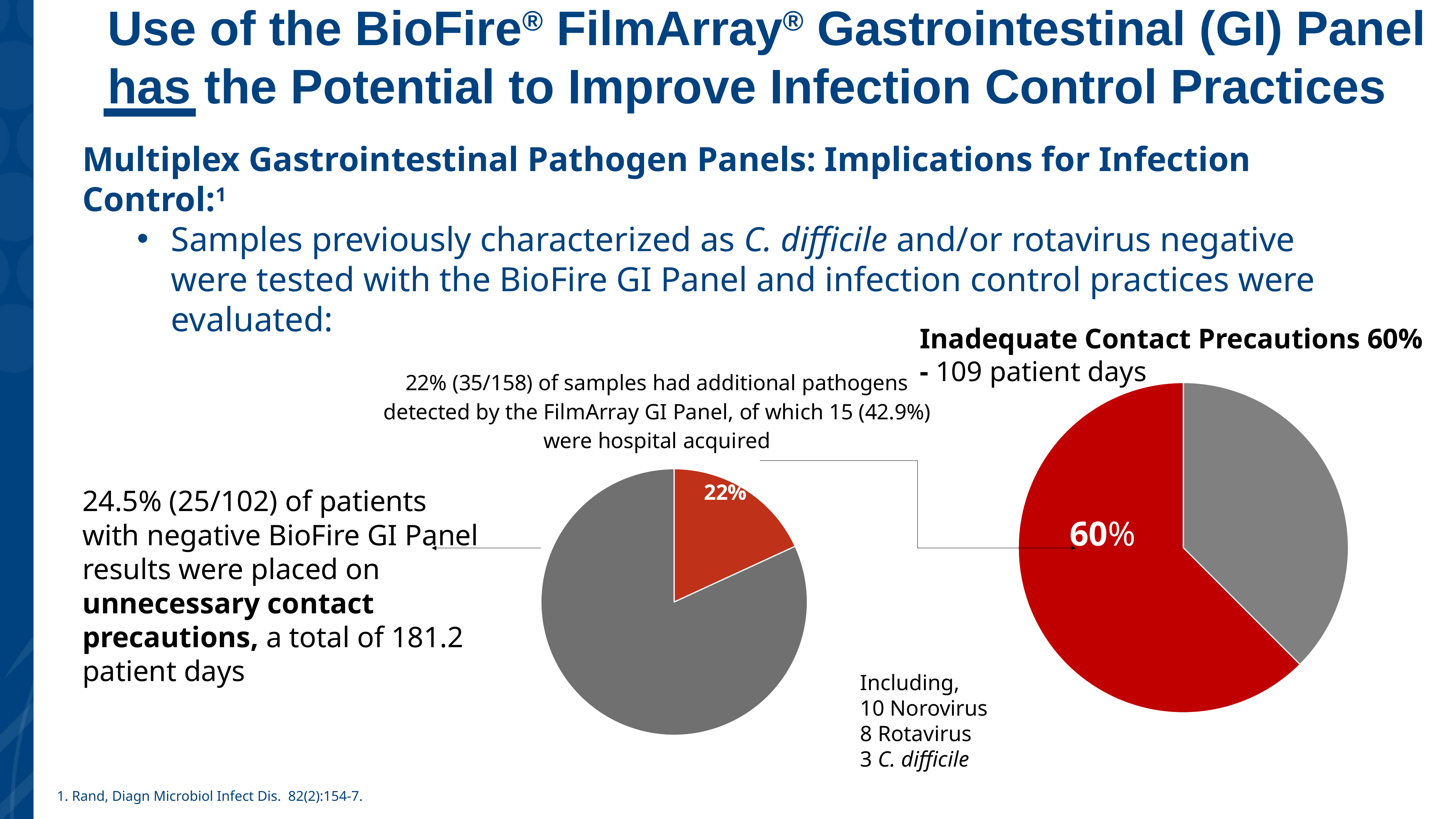
In the right pie chart, which slice is the largest, the red or the grey one? the red one In the right pie chart, is the grey slice greater or less than 50% of the pie? less In the centre pie chart, what percentage is printed on the red slice? 22% In the centre pie chart, is the grey slice greater or less than 50% of the pie? greater Which pie chart has the larger red slice, the centre one or the right one? the right one How many slices does the right pie chart have? 2 In the right pie chart, what percentage is printed on the red slice? 60% What kind of chart is the chart in the centre of the slide? pie chart What is the difference between the red slice of the right pie chart (60%) and the red slice of the centre pie chart (22%)? 38 percentage points What colour is the slice labelled 22% in the centre pie chart? red How many slices does the centre pie chart have? 2 What kind of chart is the chart on the right of the slide? pie chart